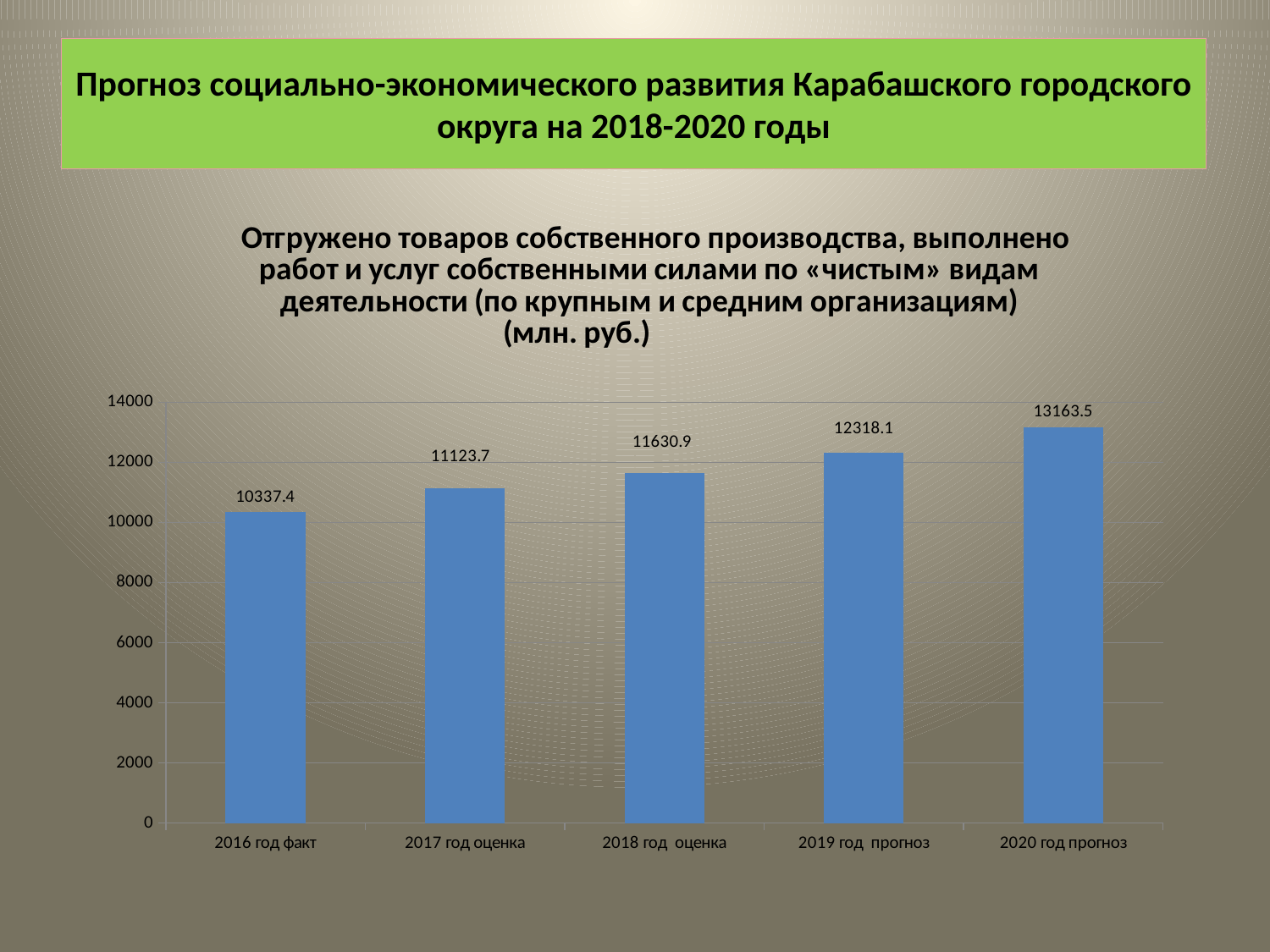
What is the value for 2018 год оценка? 11630.9 Do the values rise or fall from 2016 год факт to 2020 год прогноз? rise What is the difference between the values for 2020 год прогноз and 2016 год факт? 2826.1 What is the value for 2020 год прогноз? 13163.5 How many categories are shown on the x axis? 5 What kind of chart is shown on the slide? bar chart Is the value for 2019 год прогноз greater or less than 12000? greater Which is larger, the value for 2017 год оценка or the value for 2019 год прогноз? 2019 год прогноз Which category has the highest value? 2020 год прогноз Which category has the lowest value? 2016 год факт What is the difference between the values for 2019 год прогноз and 2018 год оценка? 687.2 What is the value for 2016 год факт? 10337.4